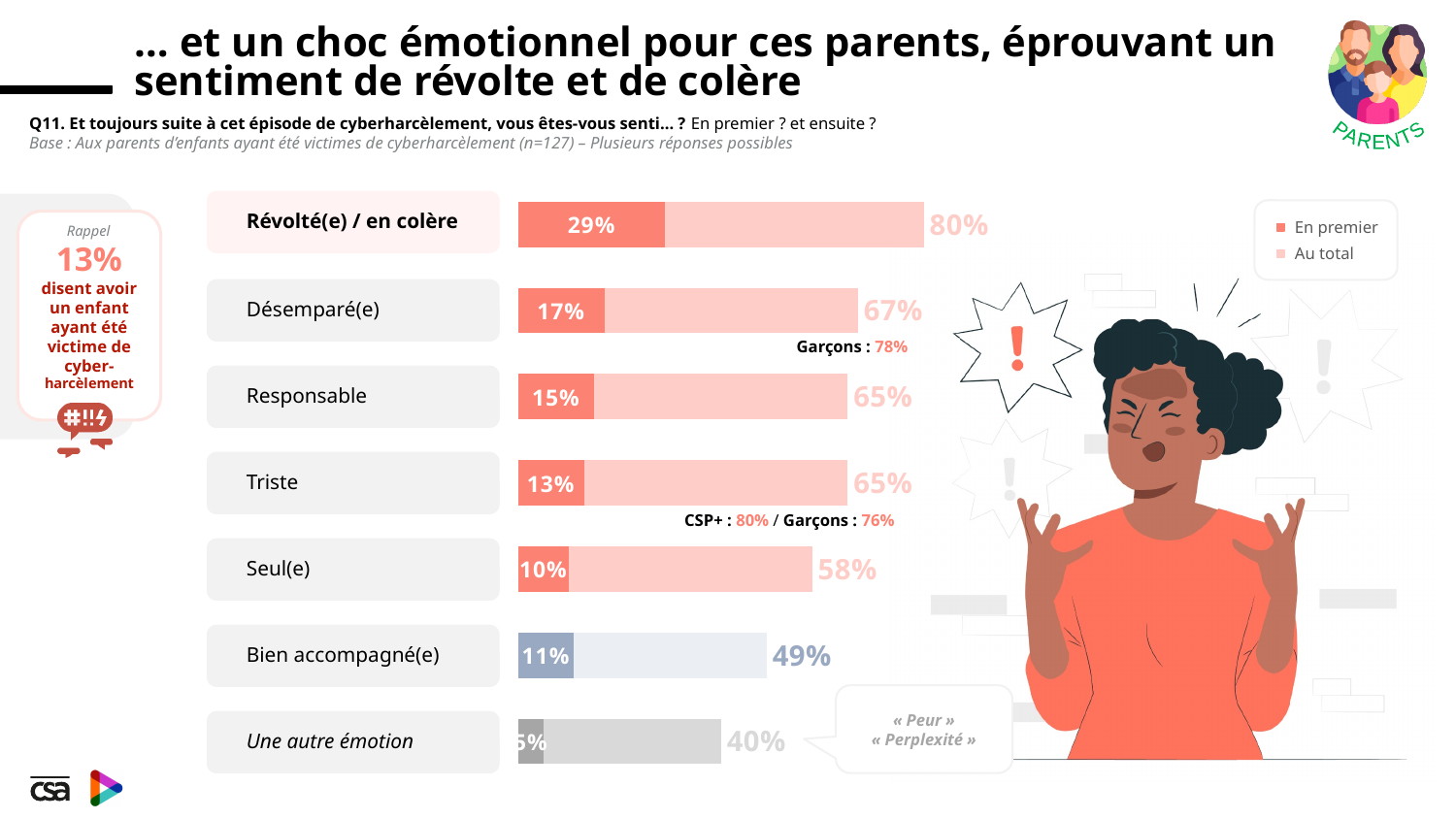
Which category has the highest 'Au total' value? Révolté(e) / en colère How many series does the legend list? 2 What is the 'Au total' value for Révolté(e) / en colère? 80% What is the 'En premier' value for Bien accompagné(e)? 11% Which category has the lowest 'Au total' value? Une autre émotion Which is larger, the 'En premier' value for Responsable or for Triste? Responsable What is the difference between the 'Au total' values for Révolté(e) / en colère and Désemparé(e)? 13% What is the 'En premier' value for Désemparé(e)? 17% What is the 'Au total' value for Seul(e)? 58% What kind of chart is shown on the slide? Bar chart How many emotion categories are shown in the chart? 7 What are the two series named in the legend? En premier and Au total